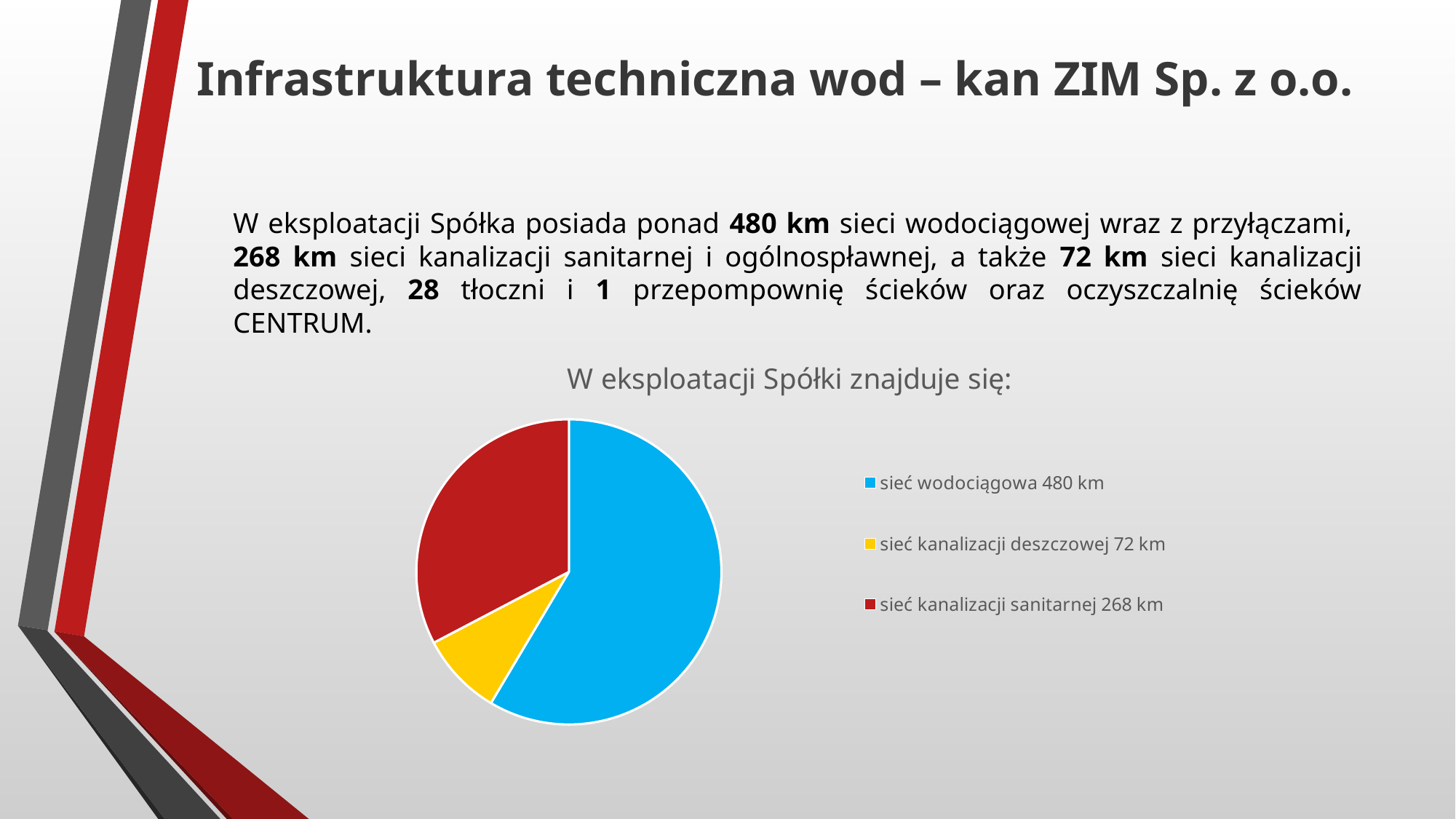
Which category has the largest slice of the pie? sieć wodociągowa 480 km What kind of chart is shown on the slide? pie chart How much longer is sieć wodociągowa than sieć kanalizacji sanitarnej? 212 km What is the length of sieć kanalizacji sanitarnej according to the chart legend? 268 km What is the chart's title? W eksploatacji Spółki znajduje się: What is the difference between sieć kanalizacji sanitarnej and sieć kanalizacji deszczowej? 196 km What is the length of sieć kanalizacji deszczowej according to the chart legend? 72 km What colour is the slice for sieć kanalizacji deszczowej? yellow How many slices does the pie chart have? 3 What is the length of sieć wodociągowa according to the chart legend? 480 km Which is larger: sieć kanalizacji sanitarnej or sieć kanalizacji deszczowej? sieć kanalizacji sanitarnej Which category has the smallest slice of the pie? sieć kanalizacji deszczowej 72 km